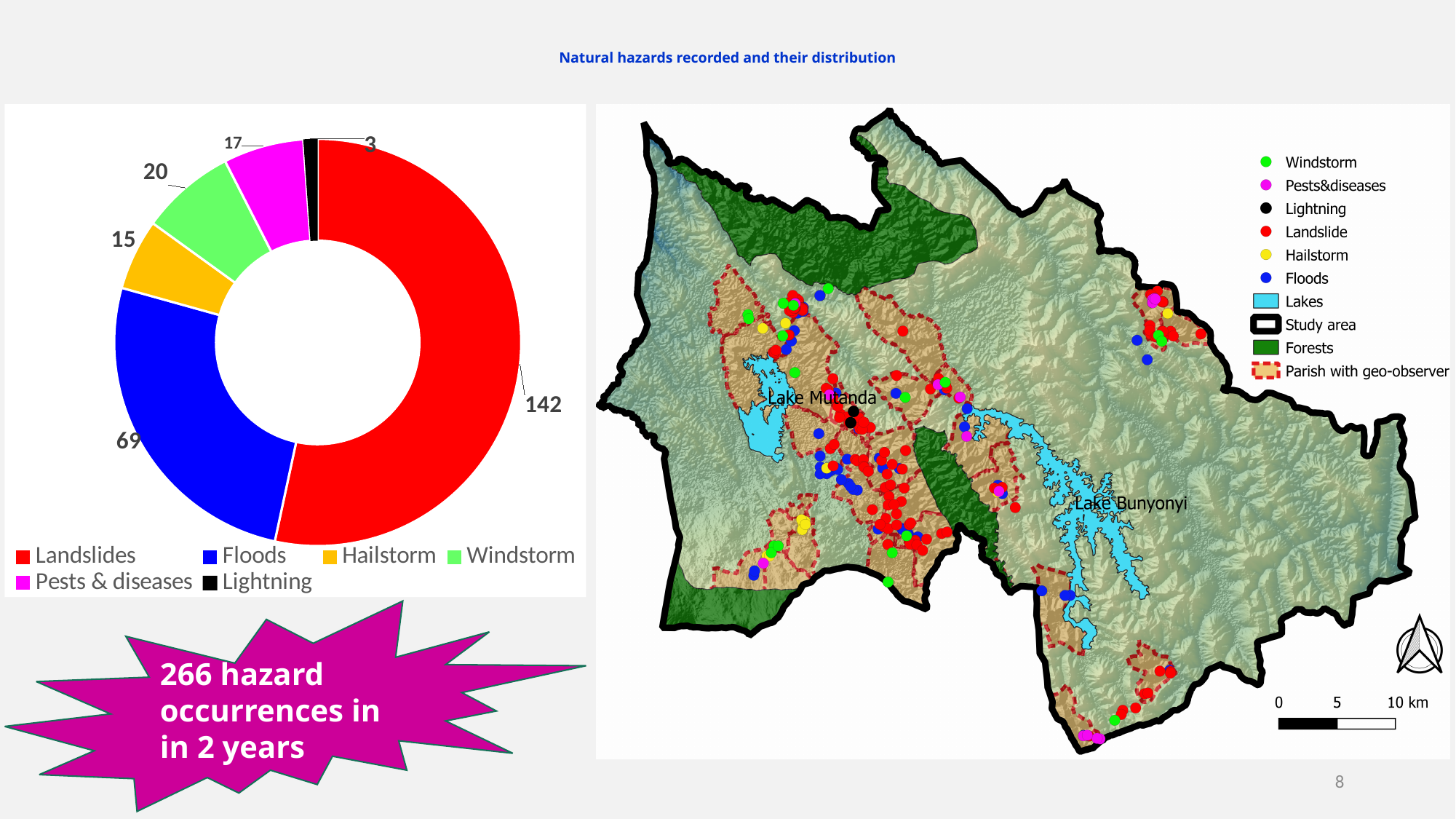
What type of chart is shown on the left of the slide? Doughnut (pie) chart How many hazard categories does the doughnut chart show? 6 In the doughnut chart, what is the value for Lightning? 3 In the doughnut chart, what is the value for Floods? 69 In the doughnut chart, what is the value for Hailstorm? 15 What is the difference between the Landslides and Floods values in the doughnut chart? 73 Which hazard category has the largest slice in the doughnut chart? Landslides In the doughnut chart, what is the value for Landslides? 142 In the doughnut chart, which is larger: Windstorm or Pests & diseases? Windstorm In the doughnut chart, what is the value for Windstorm? 20 What colour represents Floods in the doughnut chart? Blue Which hazard category has the smallest slice in the doughnut chart? Lightning